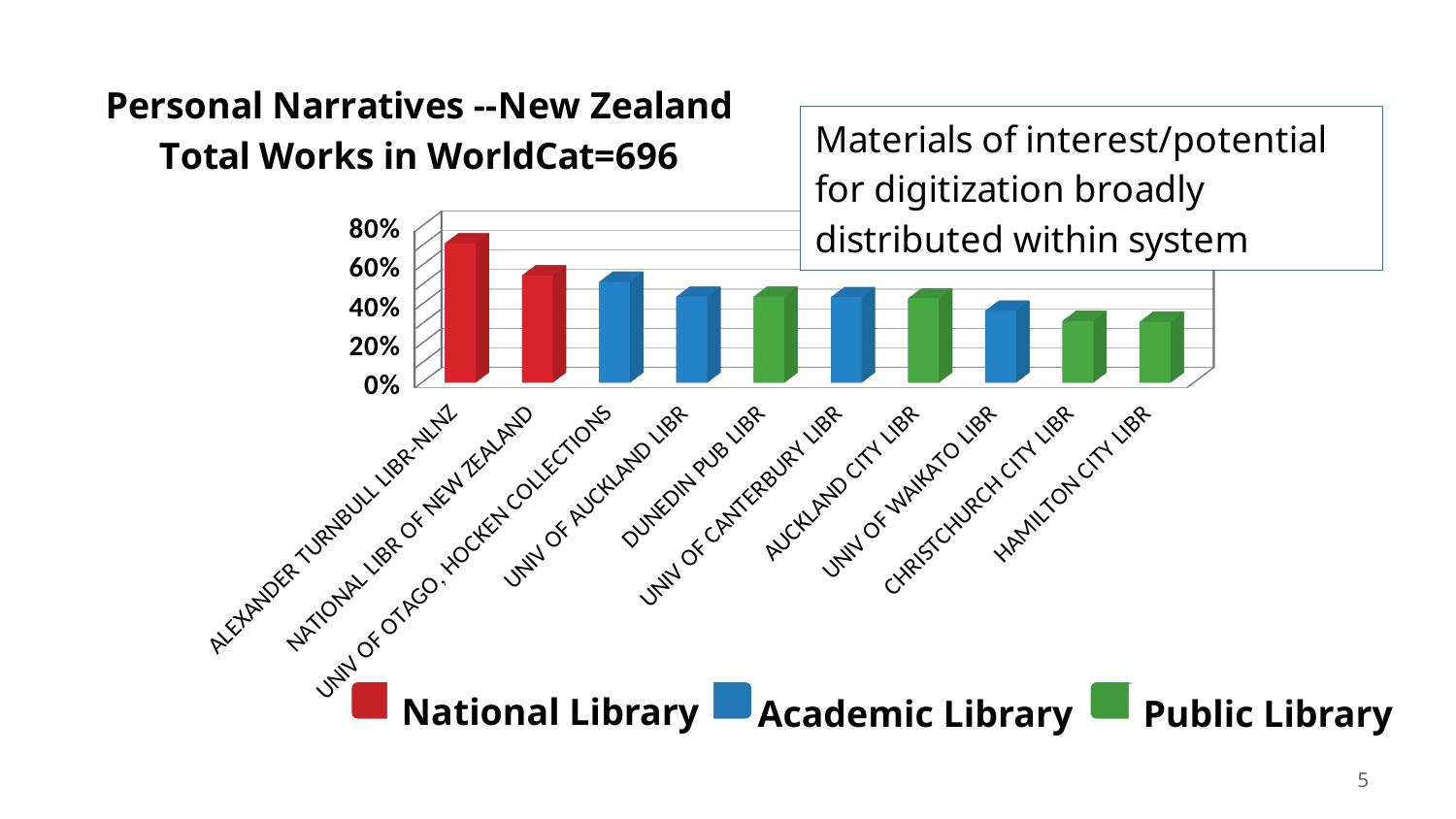
How many series does the legend list? 3 Which library has the highest value on the chart? ALEXANDER TURNBULL LIBR-NLNZ Which is larger, the value for NATIONAL LIBR OF NEW ZEALAND or the value for CHRISTCHURCH CITY LIBR? NATIONAL LIBR OF NEW ZEALAND Is the value for ALEXANDER TURNBULL LIBR-NLNZ greater or less than 60%? greater Do the bar values generally rise or fall from left to right along the x axis? fall How many libraries (categories) are plotted on the chart? 10 Is the value for UNIV OF OTAGO, HOCKEN COLLECTIONS greater or less than 40%? greater What is the total number of works in WorldCat stated in the chart title? 696 What kind of chart is shown on the slide? bar chart Which legend entry is shown in green? Public Library Is the value for HAMILTON CITY LIBR greater or less than 40%? less